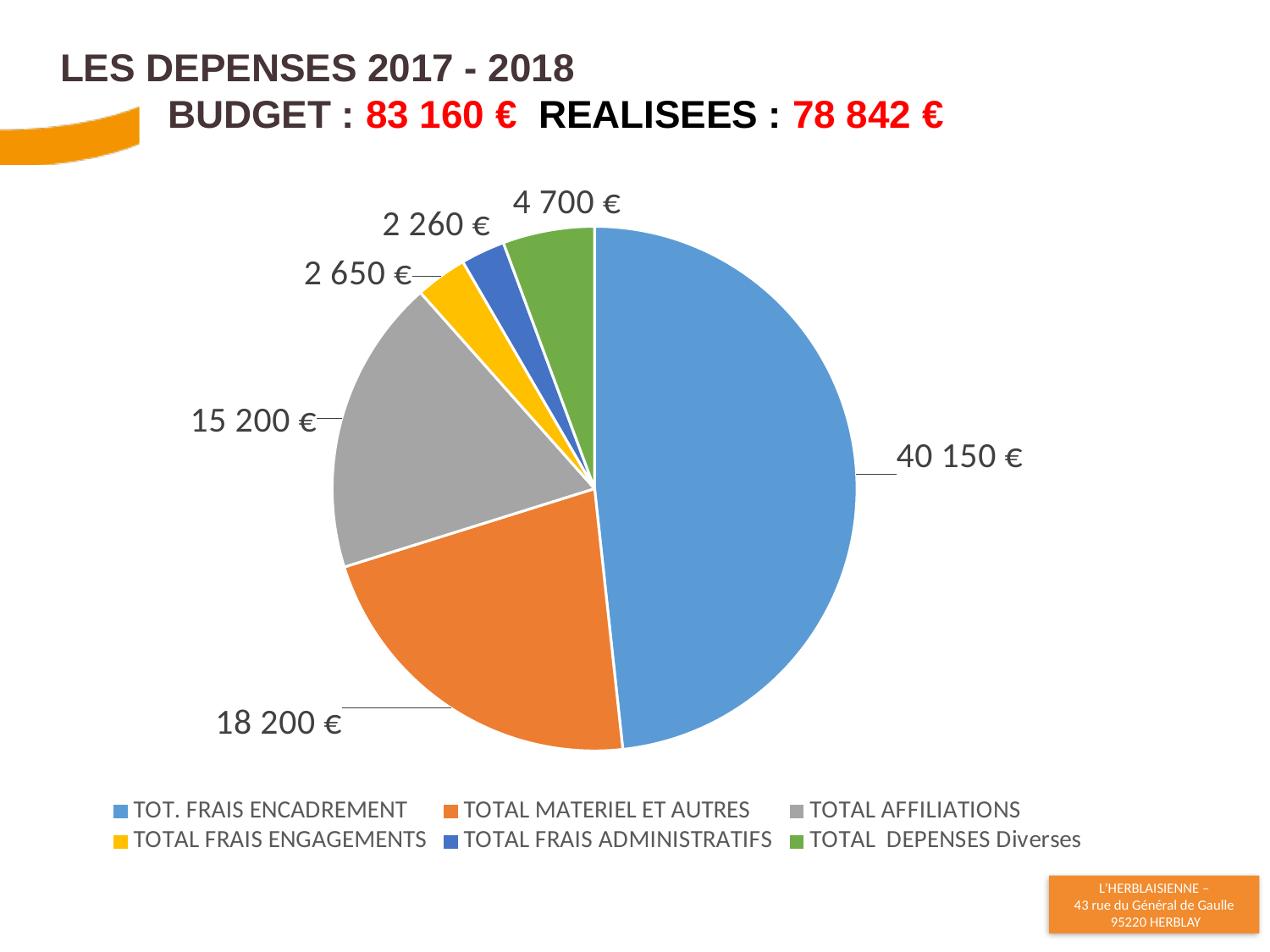
What colour is the slice for TOTAL AFFILIATIONS? Grey What is the value for TOTAL AFFILIATIONS? 15 200 € What kind of chart is shown on the slide? Pie chart What is the value for TOTAL FRAIS ADMINISTRATIFS? 2 260 € How many categories does the pie chart show? 6 Which category has the largest slice of the pie? TOT. FRAIS ENCADREMENT What is the value for TOT. FRAIS ENCADREMENT? 40 150 € Which category has the smallest slice of the pie? TOTAL FRAIS ADMINISTRATIFS What is the value for TOTAL MATERIEL ET AUTRES? 18 200 € What is the difference between TOT. FRAIS ENCADREMENT and TOTAL MATERIEL ET AUTRES? 21 950 € What is the value for TOTAL DEPENSES Diverses? 4 700 € Which is larger, TOTAL FRAIS ENGAGEMENTS or TOTAL DEPENSES Diverses? TOTAL DEPENSES Diverses